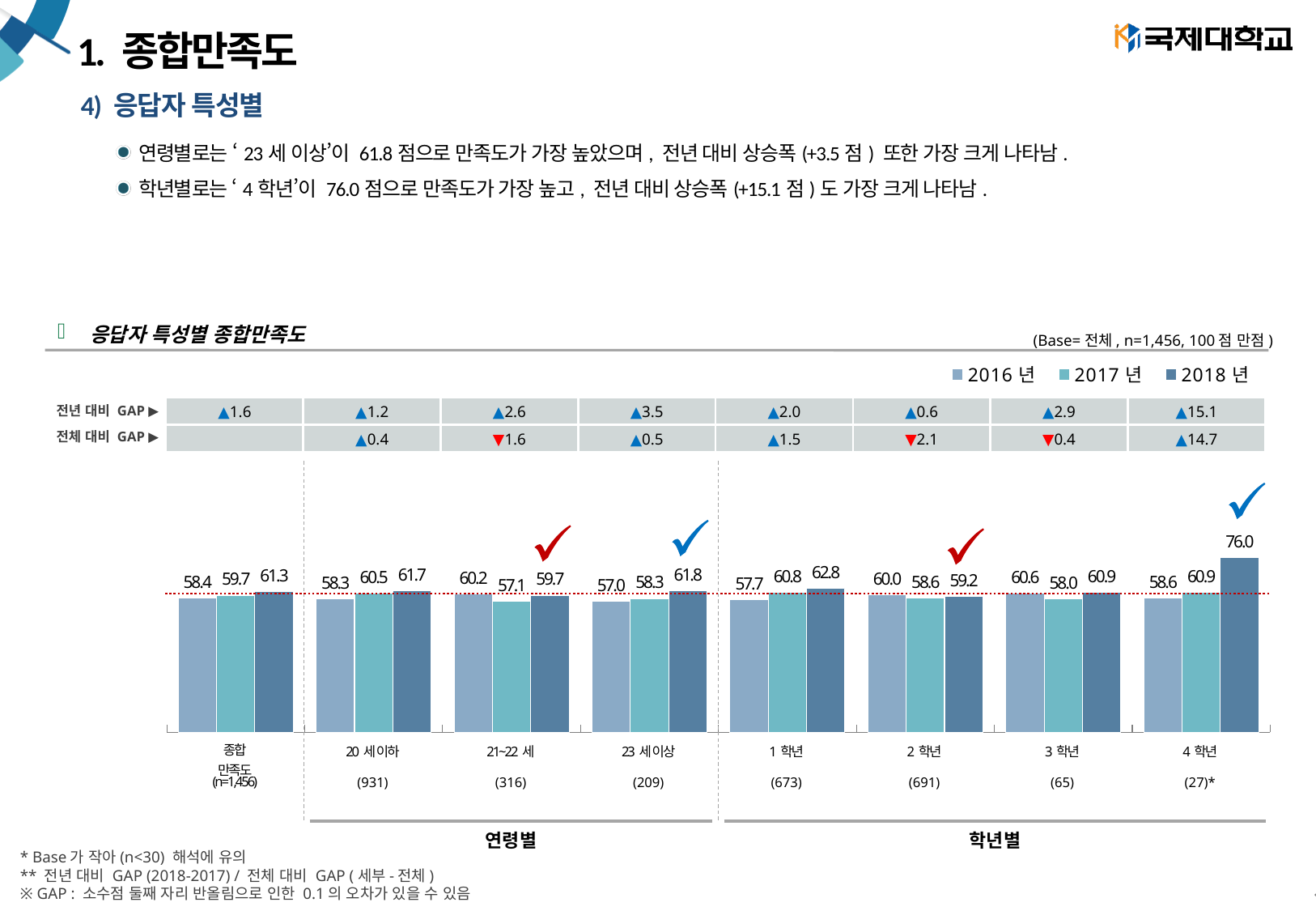
How many categories are shown on the x axis? 8 Which category has the lowest 2016년 value? 23 세이상 For 1 학년, do the values rise or fall from 2016년 to 2018년? rise How many series does the legend list? 3 What is the 전년 대비 GAP shown for 23 세이상? ▲3.5 What is the 2018년 value for 4 학년? 76.0 Which category has the highest 2018년 value? 4 학년 What is the 2016년 value for 21~22 세? 60.2 What is the 2017년 value for 종합만족도? 59.7 What is the difference between the 2018년 and 2017년 values for 4 학년? 15.1 What kind of chart is shown? bar chart Which is larger for 2 학년: the 2016년 value or the 2017년 value? 2016년